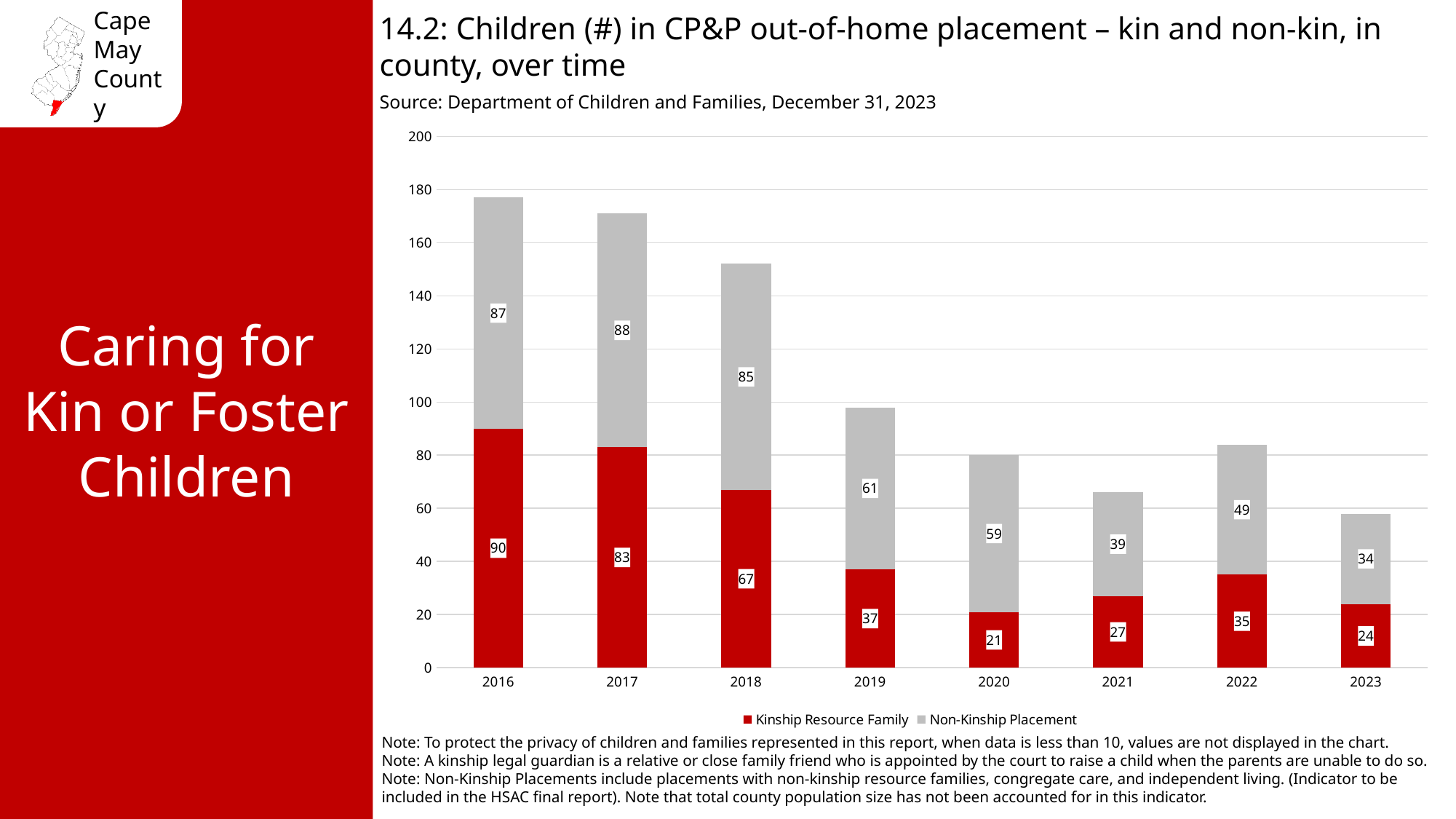
What is the Non-Kinship Placement value for 2019? 61 Which year has the highest Non-Kinship Placement value? 2017 Overall, do the total bar heights rise or fall from 2016 to 2023? Fall Which is larger in 2021, the Kinship Resource Family value or the Non-Kinship Placement value? Non-Kinship Placement How many series does the legend list? 2 What type of chart is shown on the slide? Stacked bar chart What is the Kinship Resource Family value for 2016? 90 What is the total number of children in out-of-home placement in 2018? 152 What is the difference between the Non-Kinship Placement values for 2022 and 2023? 15 What is the Kinship Resource Family value for 2023? 24 How many years are shown on the x axis? 8 Which year has the lowest Kinship Resource Family value? 2020